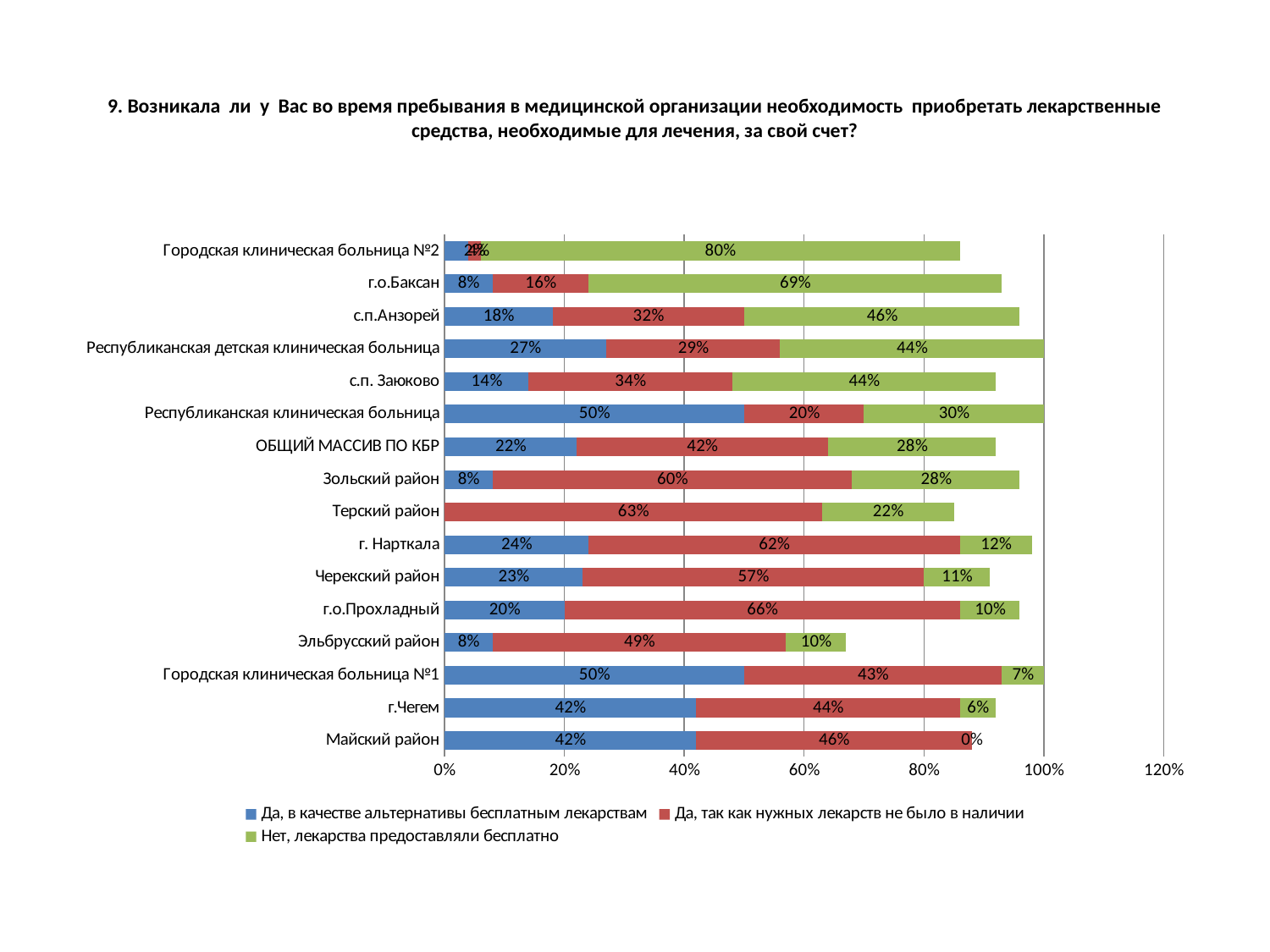
What kind of chart is shown on the slide? Stacked bar chart What is the total of the stacked bar for г.о.Баксан? 93% Which category has the highest value for "Нет, лекарства предоставляли бесплатно"? Городская клиническая больница №2 Which colour represents "Нет, лекарства предоставляли бесплатно" in the chart? Green What is the value of "Да, в качестве альтернативы бесплатным лекарствам" for Республиканская клиническая больница? 50% Which is larger for ОБЩИЙ МАССИВ ПО КБР: "Да, так как нужных лекарств не было в наличии" or "Нет, лекарства предоставляли бесплатно"? Да, так как нужных лекарств не было в наличии What is the value of "Нет, лекарства предоставляли бесплатно" for Городская клиническая больница №2? 80% How many categories (organisations/districts) are plotted on the chart? 16 Which category has the lowest value for "Нет, лекарства предоставляли бесплатно"? Майский район What is the difference between the "Да, так как нужных лекарств не было в наличии" values for Зольский район and г.о.Баксан? 44% What is the value of "Да, так как нужных лекарств не было в наличии" for г.о.Прохладный? 66% How many series does the legend list? 3